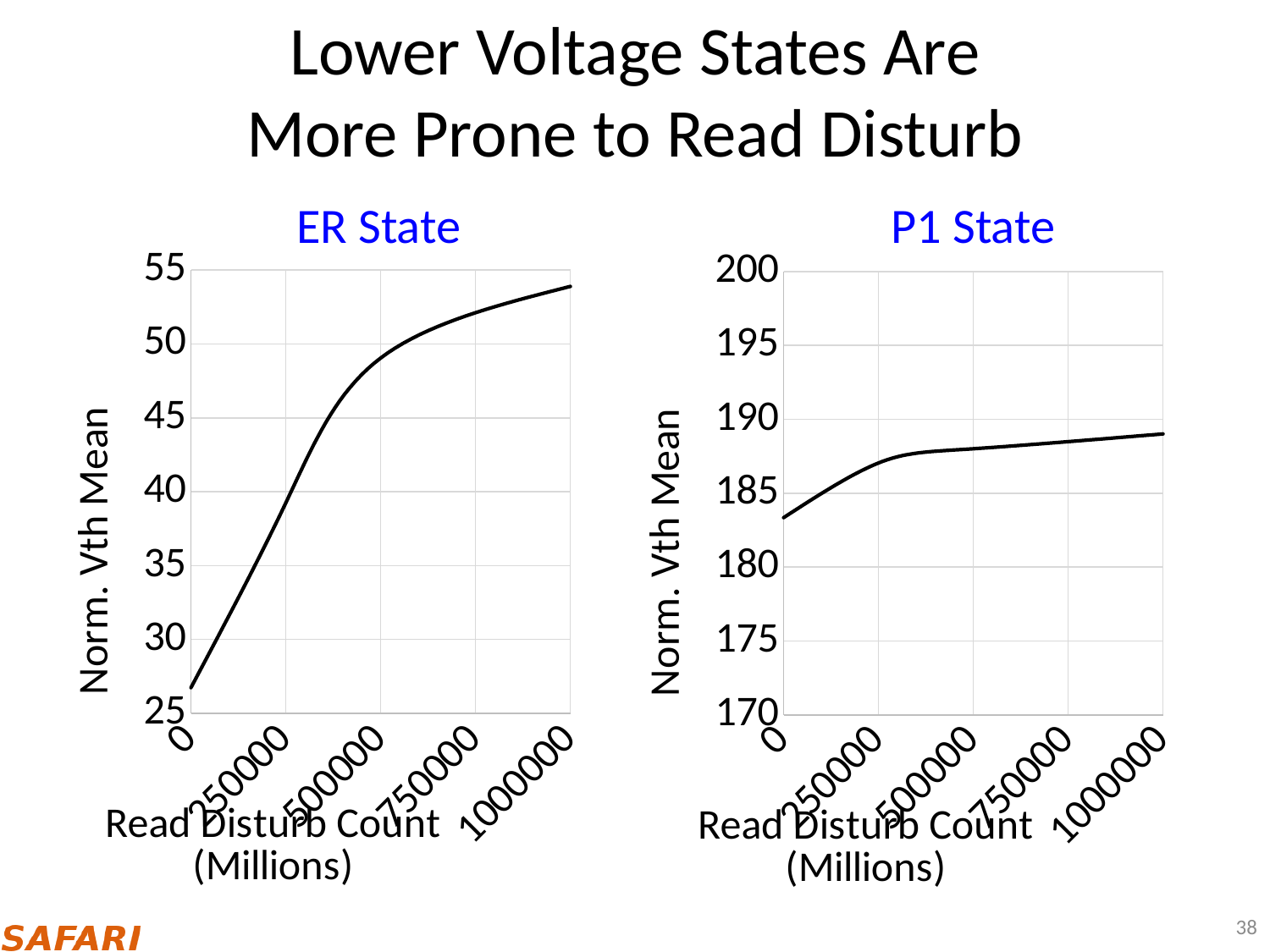
What kind of chart is the P1 State chart? line chart In the P1 State chart, is the Norm. Vth Mean at a Read Disturb Count of 1000000 greater or less than 190? less In the ER State chart, is the Norm. Vth Mean at a Read Disturb Count of 1000000 greater or less than 50? greater In the ER State chart, is the Norm. Vth Mean at a Read Disturb Count of 500000 greater or less than 45? greater In the P1 State chart, does Norm. Vth Mean rise or fall as Read Disturb Count increases? rise What is the y-axis label of the P1 State chart? Norm. Vth Mean What kind of chart is the ER State chart? line chart What is the x-axis label of the ER State chart? Read Disturb Count (Millions) In the ER State chart, does Norm. Vth Mean rise or fall as Read Disturb Count increases? rise